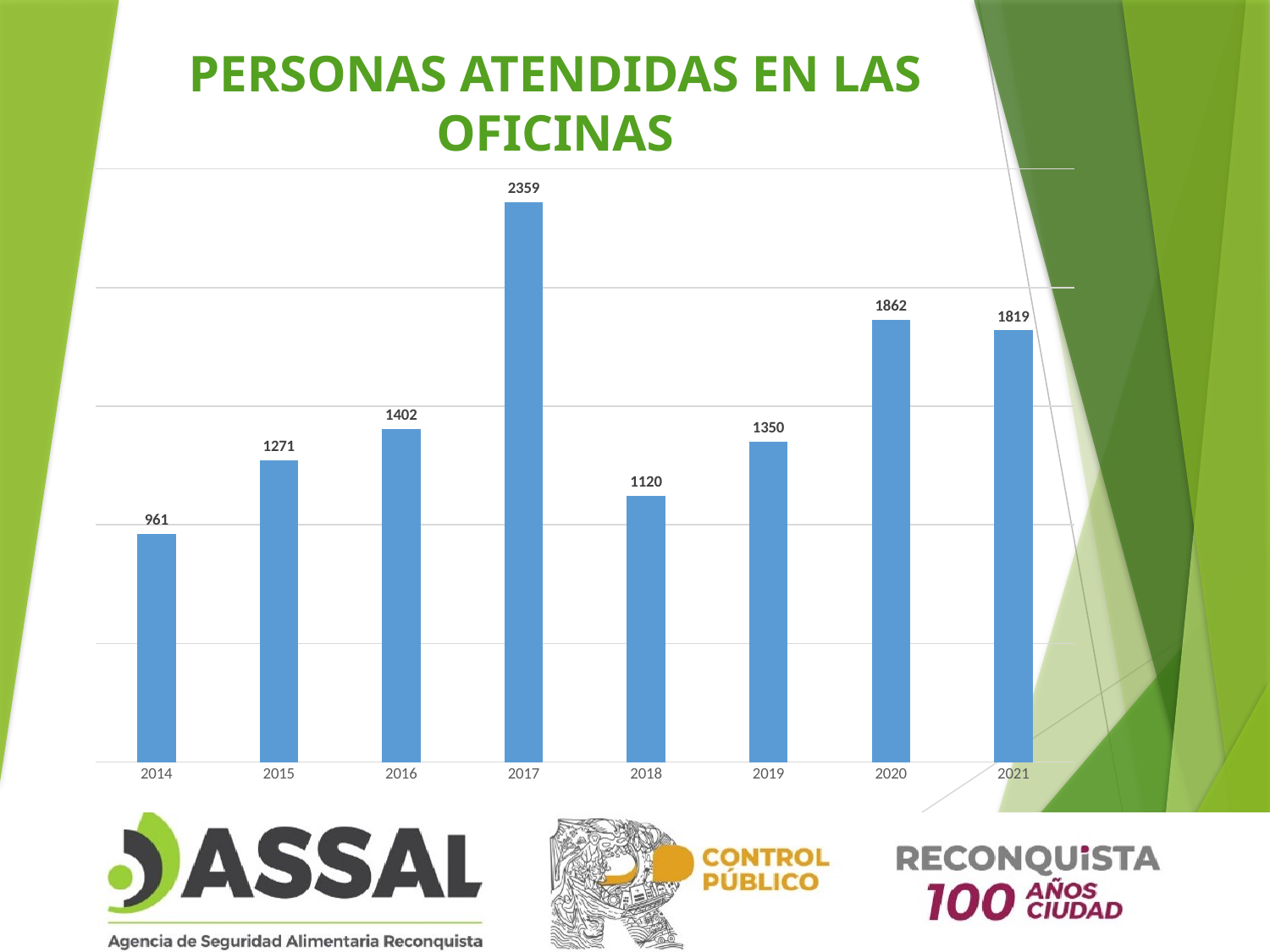
What kind of chart is shown? bar chart Which year has the highest value? 2017 Which year has the lowest value? 2014 What is the value for 2020? 1862 How many years are shown on the x axis? 8 What is the value for 2017? 2359 What is the value for 2014? 961 Do the values rise or fall from 2014 to 2017? rise What is the difference between the values for 2020 and 2021? 43 What is the title of the chart? PERSONAS ATENDIDAS EN LAS OFICINAS What is the difference between the values for 2017 and 2018? 1239 Which is larger, the value for 2016 or the value for 2019? 2016